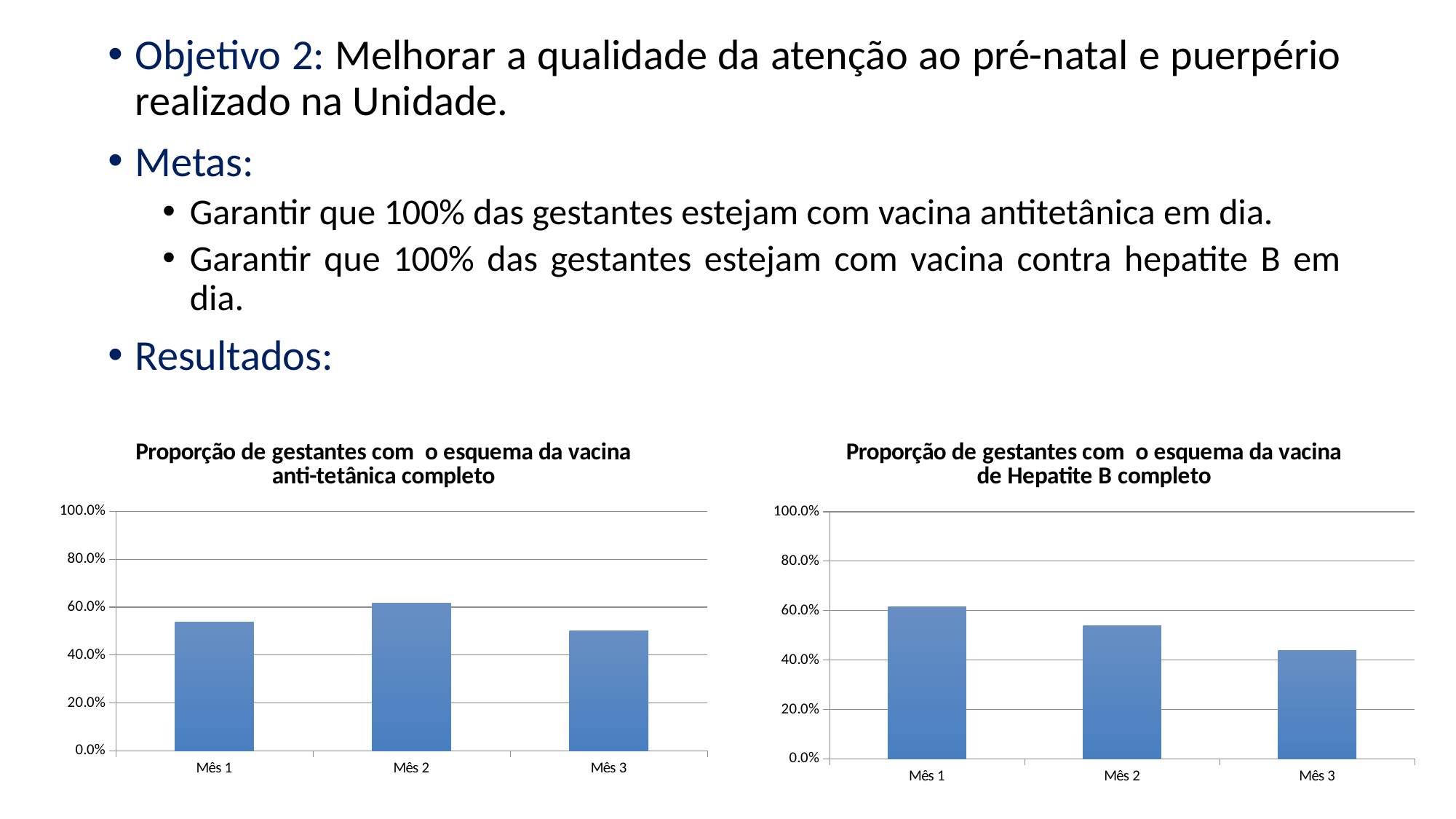
In the right chart (vacina de Hepatite B), do the values rise or fall from Mês 1 to Mês 3? Fall In the right chart (vacina de Hepatite B), which is larger, the value for Mês 1 or the value for Mês 2? Mês 1 In the right chart (vacina de Hepatite B), is the value for Mês 3 greater or less than 40.0%? greater What is the title of the right chart? Proporção de gestantes com o esquema da vacina de Hepatite B completo In the left chart (vacina anti-tetânica), how many months are plotted? 3 In the left chart (vacina anti-tetânica), is the value for Mês 3 greater or less than 60.0%? less In the left chart (Proporção de gestantes com o esquema da vacina anti-tetânica completo), which month has the highest value? Mês 2 What kind of chart is the left chart (vacina anti-tetânica)? Bar chart In the right chart (Proporção de gestantes com o esquema da vacina de Hepatite B completo), which month has the highest value? Mês 1 In the right chart (Proporção de gestantes com o esquema da vacina de Hepatite B completo), which month has the lowest value? Mês 3 In the left chart (Proporção de gestantes com o esquema da vacina anti-tetânica completo), which month has the lowest value? Mês 3 In the left chart (vacina anti-tetânica), is the value for Mês 2 greater or less than 60.0%? greater